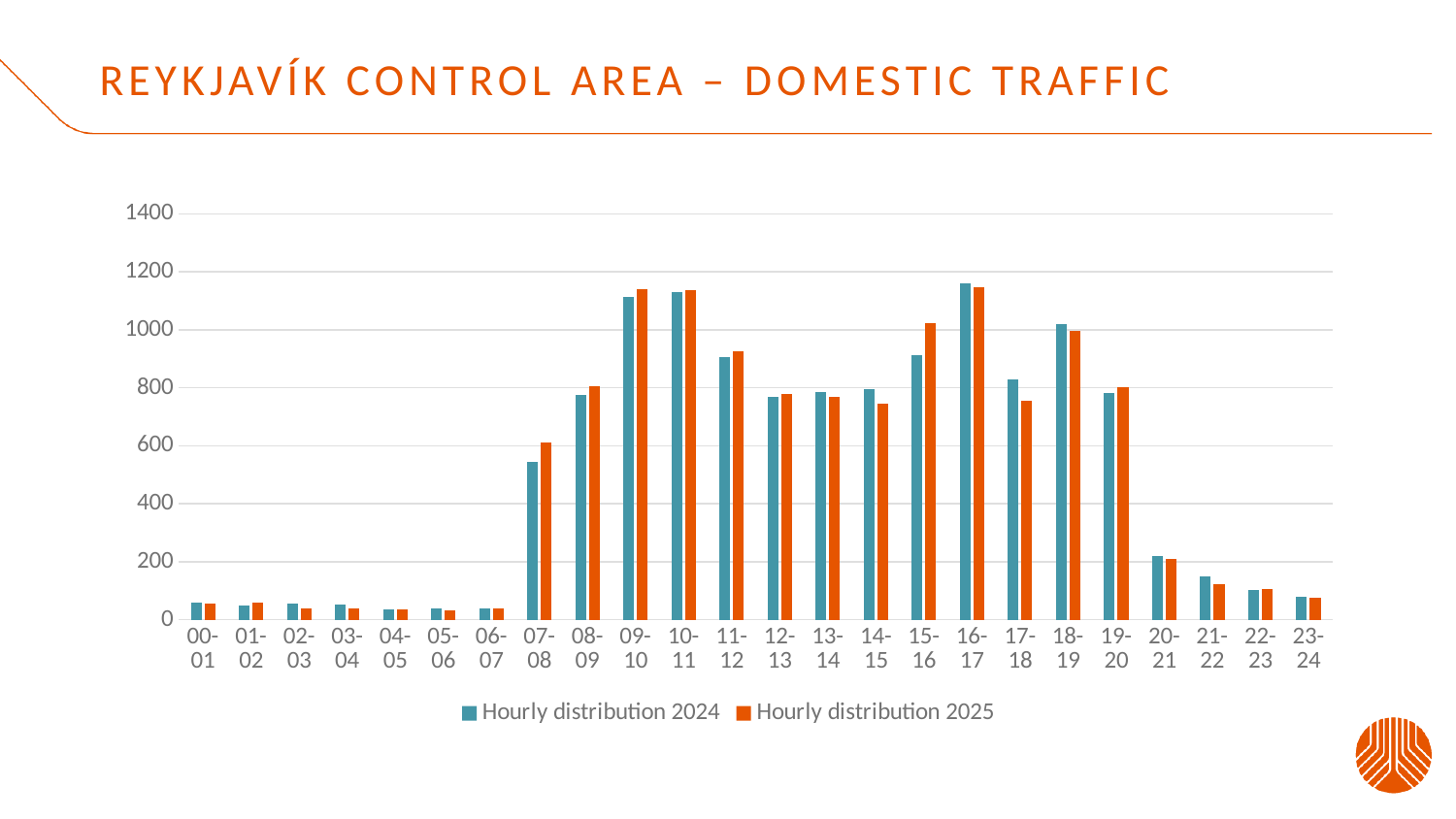
What kind of chart is shown on the slide? bar chart Is the Hourly distribution 2025 value for 15-16 greater or less than 1000? greater Which hour has the highest Hourly distribution 2024 value? 16-17 Is the Hourly distribution 2024 value for 07-08 greater or less than 600? less What is the title of the slide? Reykjavík Control Area – Domestic Traffic Is the Hourly distribution 2024 value for 11-12 greater or less than 800? greater For the 17-18 hour, which series has the larger value, Hourly distribution 2024 or Hourly distribution 2025? Hourly distribution 2024 Do the Hourly distribution 2024 values rise or fall from 07-08 to 09-10? rise For the 15-16 hour, which series has the larger value, Hourly distribution 2024 or Hourly distribution 2025? Hourly distribution 2025 How many series does the legend list? 2 How many hourly categories are shown on the x axis? 24